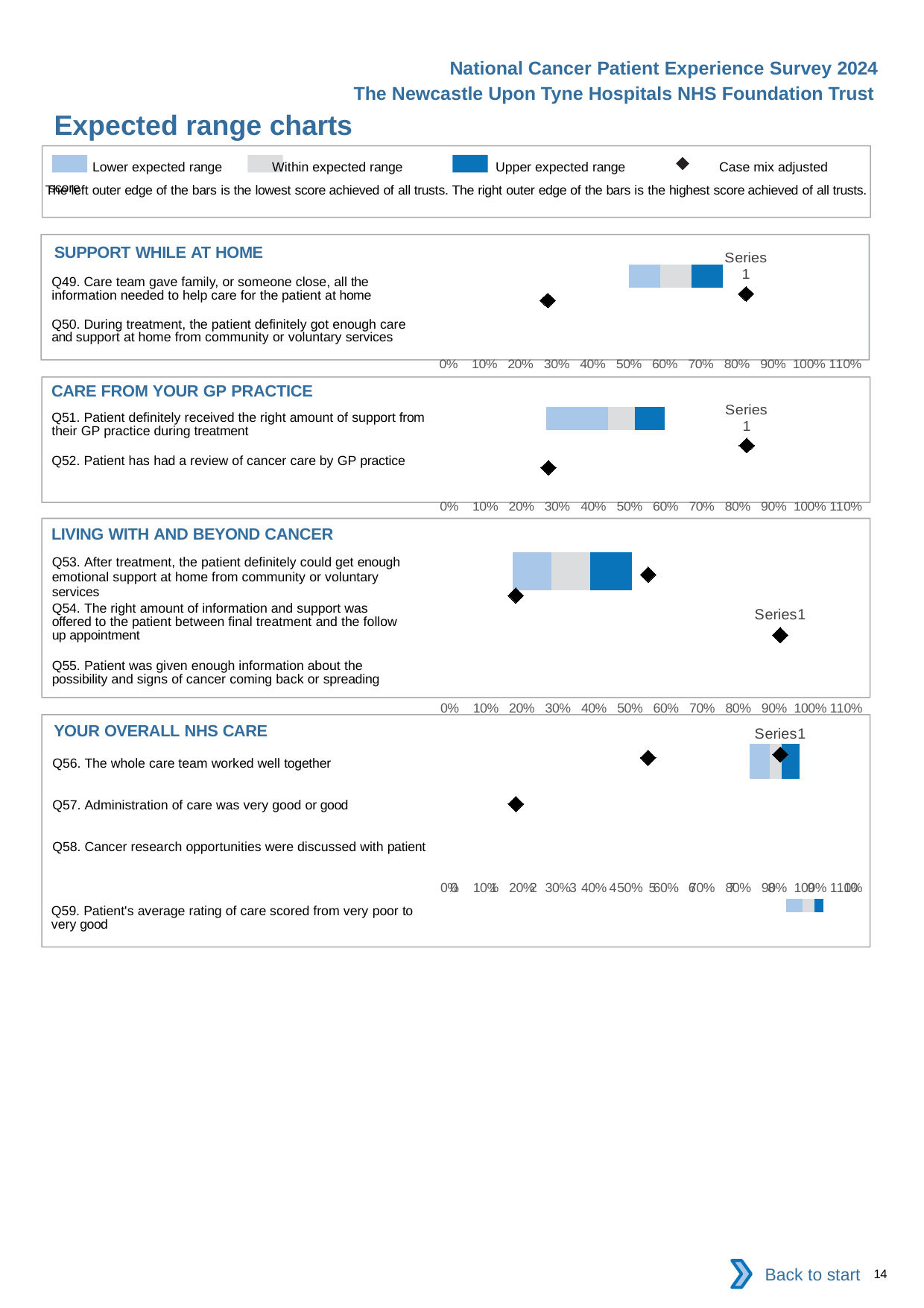
In the LIVING WITH AND BEYOND CANCER chart, is the left edge of the expected range bar greater or less than 30%? less How many questions are listed in the YOUR OVERALL NHS CARE section? 4 In the CARE FROM YOUR GP PRACTICE chart, is the right edge of the expected range bar greater or less than 70%? less In the YOUR OVERALL NHS CARE chart, is the expected range bar for Q56 greater or less than 70%? greater How many questions are listed in the CARE FROM YOUR GP PRACTICE section? 2 Which legend entry is shown with a black diamond marker? Case mix adjusted score What kind of chart is used in the SUPPORT WHILE AT HOME section? bar chart How many entries does the legend at the top of the slide list? 4 What is the highest tick label shown on the x axis of the SUPPORT WHILE AT HOME chart? 110% Which legend entry is shown in the darkest blue colour? Upper expected range How many questions are listed in the LIVING WITH AND BEYOND CANCER section? 3